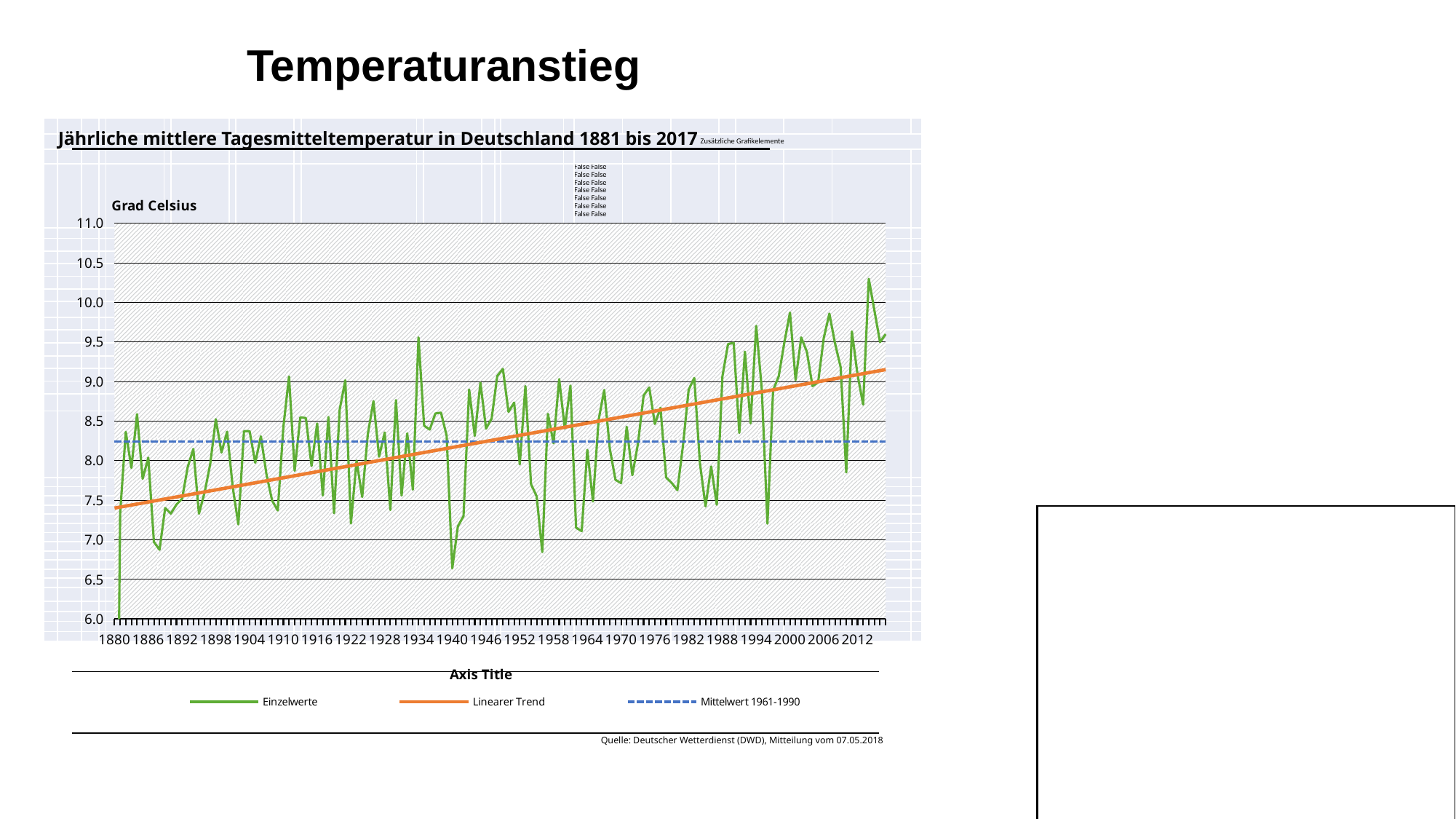
Does the Linearer Trend line rise or fall from 1880 to 2012? rise Is the Linearer Trend value at 1880 greater or less than 8.0? less How many year labels are printed on the horizontal axis? 23 What unit is shown as the label of the vertical axis? Grad Celsius How many series does the legend list? 3 Is the value of the Mittelwert 1961-1990 line greater or less than 8.0? greater Is the Linearer Trend value at 2012 greater or less than 9.0? greater What kind of chart is shown on the slide? line chart Which is larger at 2012: the Linearer Trend value or the Mittelwert 1961-1990 value? Linearer Trend What is the title of the chart? Jährliche mittlere Tagesmitteltemperatur in Deutschland 1881 bis 2017